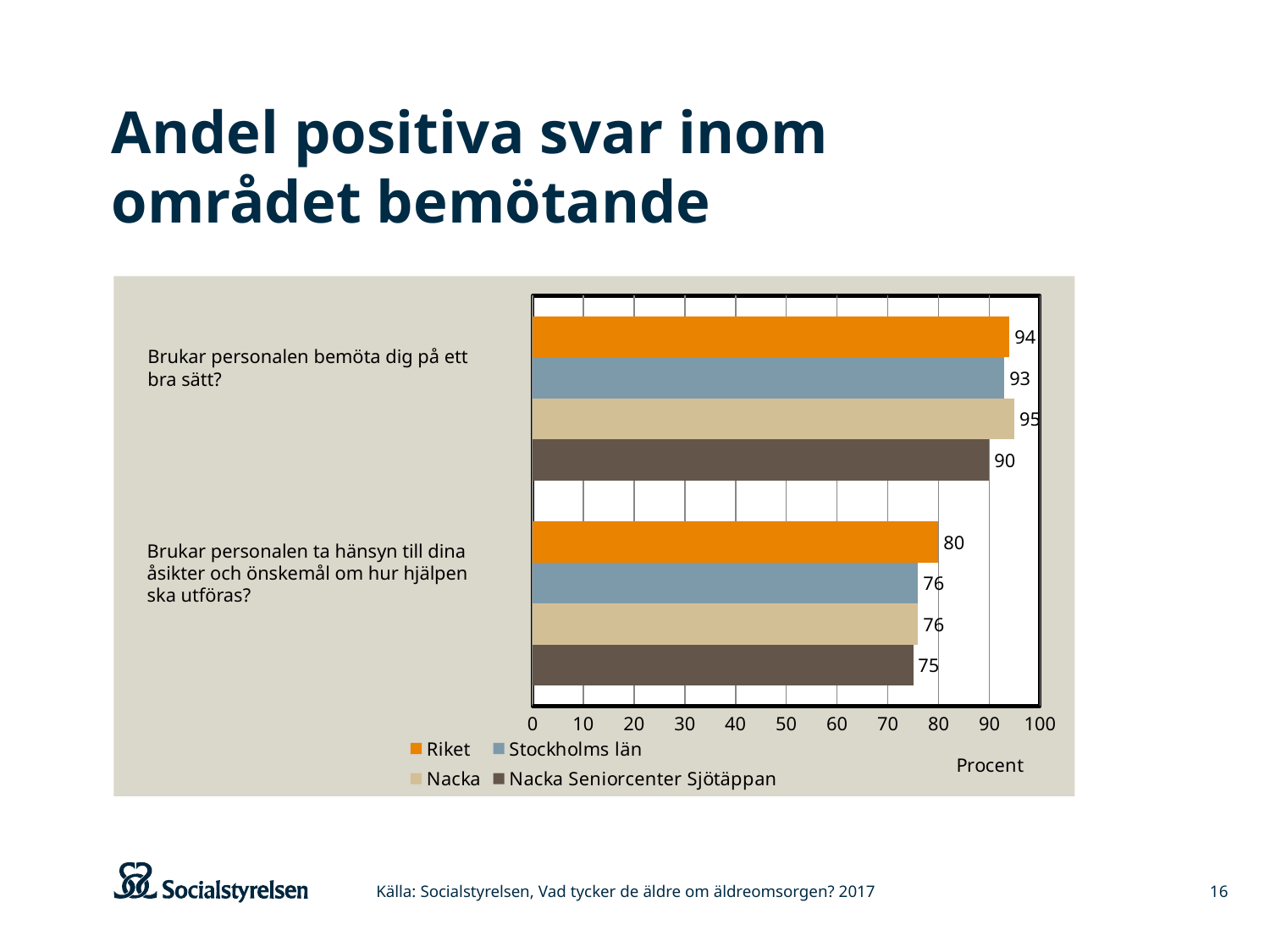
Which series has the highest value for "Brukar personalen bemöta dig på ett bra sätt?"? Nacka For "Brukar personalen bemöta dig på ett bra sätt?", which is larger: the value for Nacka or the value for Nacka Seniorcenter Sjötäppan? Nacka What is the value for Riket for "Brukar personalen bemöta dig på ett bra sätt?"? 94 What is the difference between the Riket value and the Nacka Seniorcenter Sjötäppan value for "Brukar personalen ta hänsyn till dina åsikter och önskemål om hur hjälpen ska utföras?"? 5 Is the value for Riket for "Brukar personalen ta hänsyn till dina åsikter och önskemål om hur hjälpen ska utföras?" greater or less than 70? greater What is the value for Nacka Seniorcenter Sjötäppan for "Brukar personalen ta hänsyn till dina åsikter och önskemål om hur hjälpen ska utföras?"? 75 Which series has the lowest value for "Brukar personalen bemöta dig på ett bra sätt?"? Nacka Seniorcenter Sjötäppan What is the label of the x axis? Procent How many series does the legend list? 4 What is the value for Stockholms län for "Brukar personalen bemöta dig på ett bra sätt?"? 93 What is the value for Nacka for "Brukar personalen ta hänsyn till dina åsikter och önskemål om hur hjälpen ska utföras?"? 76 What kind of chart is shown on the slide? Bar chart